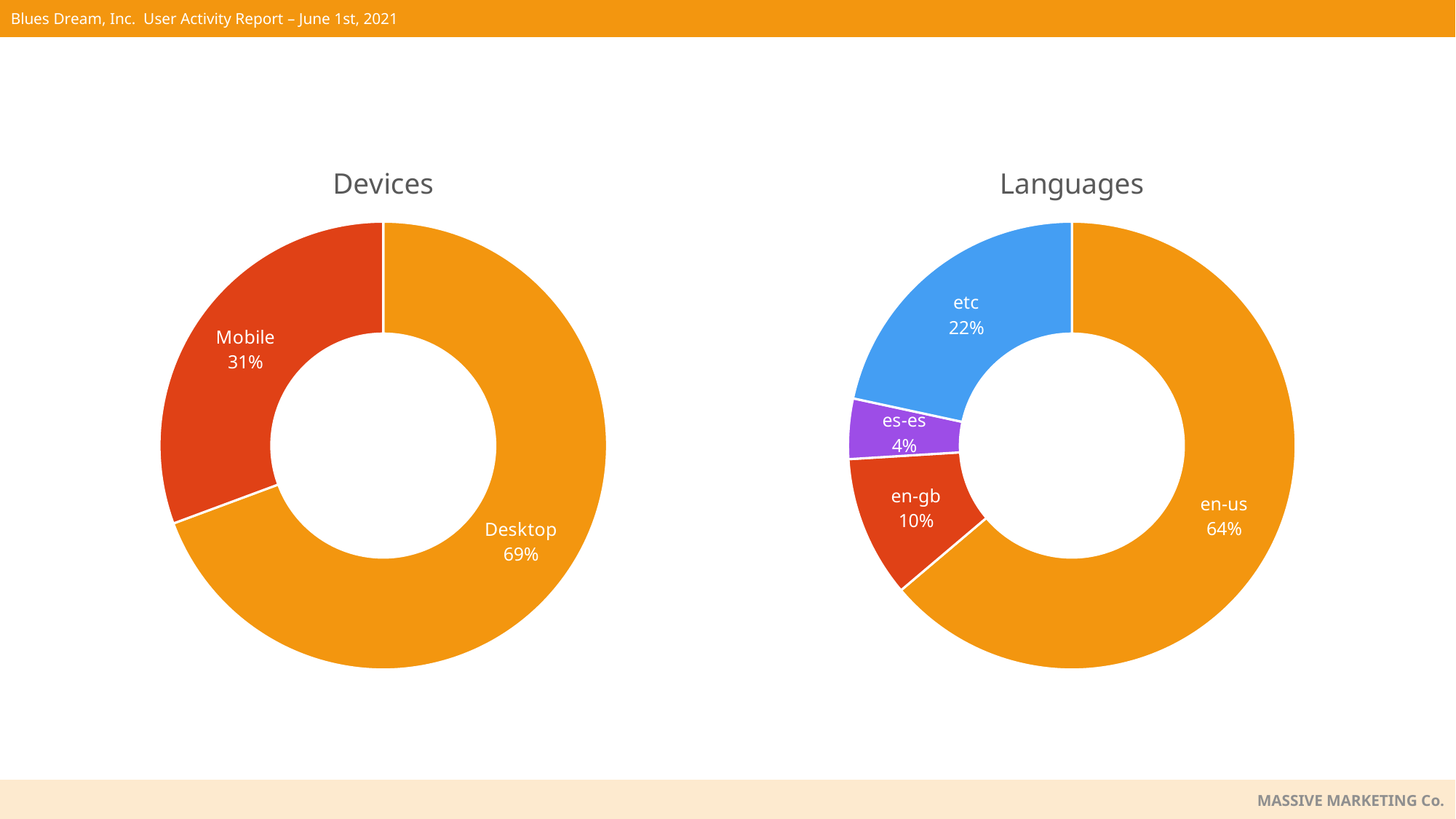
In the Languages chart, which language has the smallest share? es-es In the Devices chart, which device has the larger share? Desktop In the Devices chart, what share of users are on Desktop? 69% In the Languages chart, which language has the largest share? en-us What type of chart is the Languages chart? Doughnut (pie) chart In the Languages chart, what share is en-gb? 10% In the Languages chart, what share is en-us? 64% In the Devices chart, what is the difference in percentage points between Desktop and Mobile? 38 In the Devices chart, what share of users are on Mobile? 31% In the Languages chart, which is larger, etc or en-gb? etc In the Languages chart, how many slices are there? 4 In the Devices chart, how many slices are there? 2